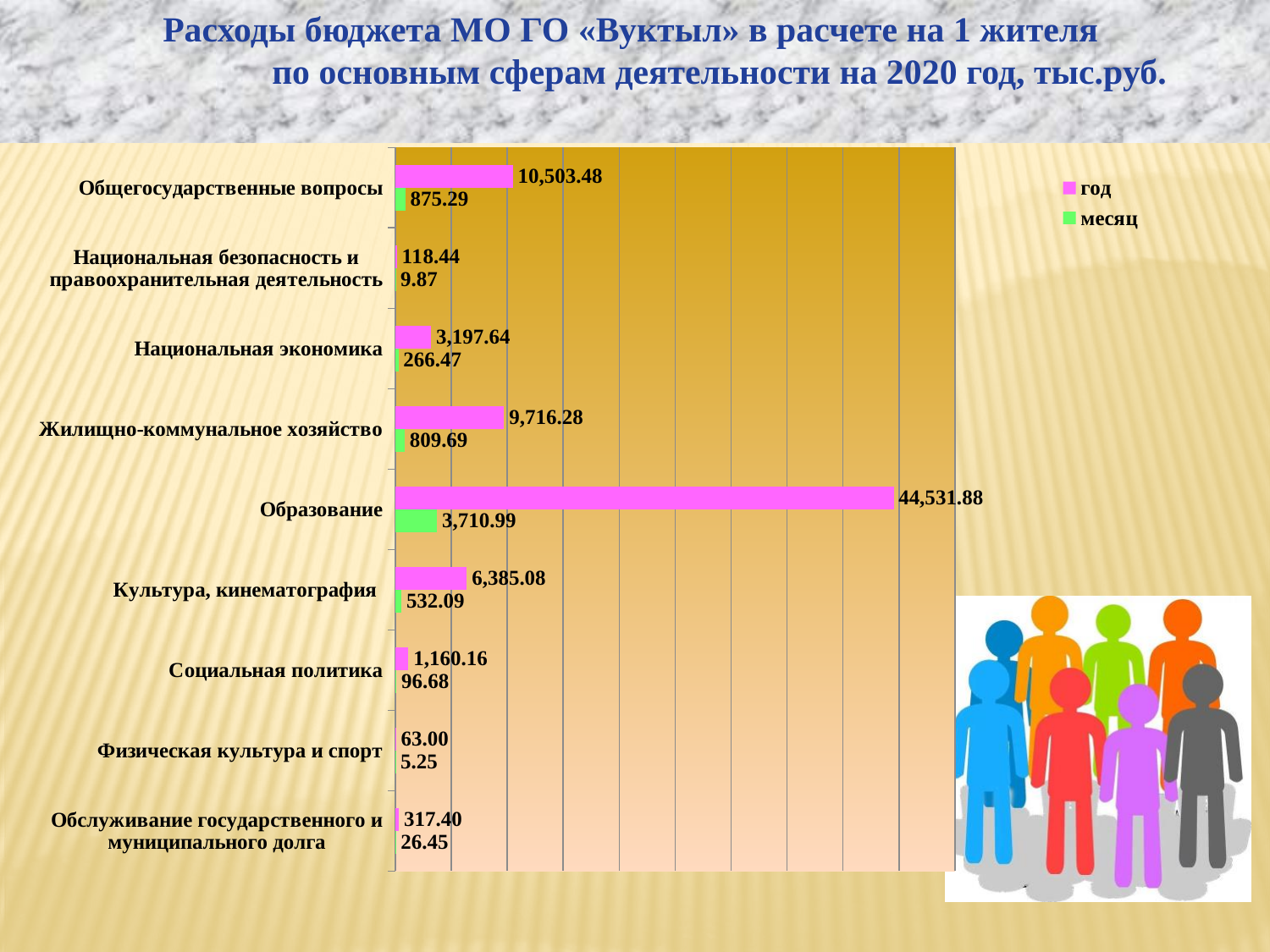
How many categories are shown on the chart? 9 What is the value of the 'год' series for Культура, кинематография? 6,385.08 Which category has the lowest value in the 'месяц' series? Физическая культура и спорт What is the value of the 'месяц' series for Физическая культура и спорт? 5.25 Which is larger in the 'год' series: Общегосударственные вопросы or Жилищно-коммунальное хозяйство? Общегосударственные вопросы What type of chart is shown on the slide? bar chart What are the two legend entries of the chart? год and месяц What is the difference between the 'год' values for Общегосударственные вопросы and Жилищно-коммунальное хозяйство? 787.20 How many series does the legend list? 2 What is the value of the 'год' series for Образование? 44,531.88 Which category has the highest value in the 'год' series? Образование What is the value of the 'месяц' series for Жилищно-коммунальное хозяйство? 809.69